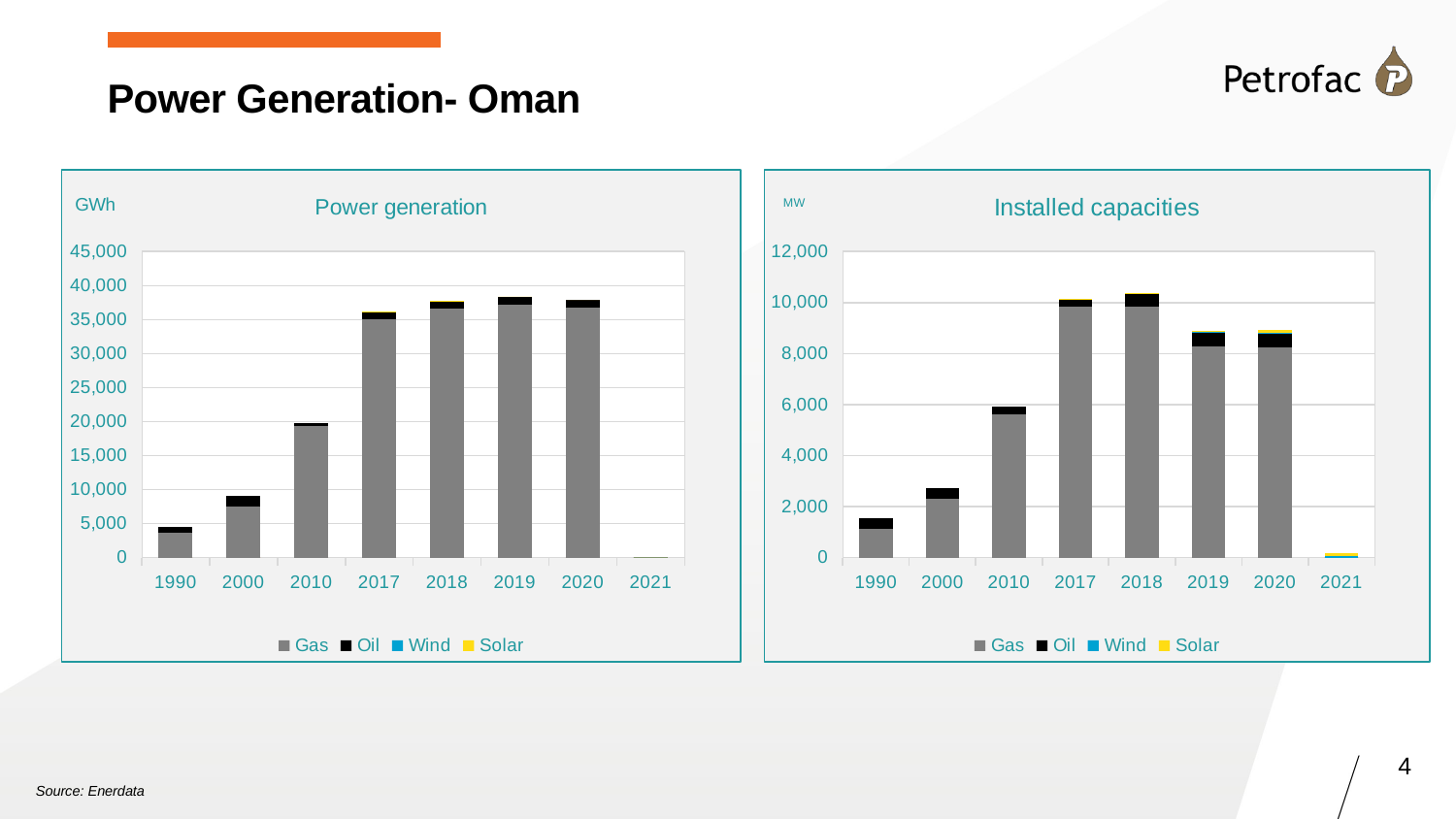
What unit is shown on the y axis of the Installed capacities chart? MW In the Power generation chart, is the total for 1990 greater or less than 10,000? less What kind of chart is the Power generation chart? bar chart In the Installed capacities chart, is the total for 2019 greater or less than 10,000? less In the Installed capacities chart, which year has the lowest total? 2021 In the Power generation chart, is the total for 2010 greater or less than 15,000? greater In the Installed capacities chart, do the totals rise or fall from 1990 to 2017? rise How many years are shown on the x axis of the Installed capacities chart? 8 In the Power generation chart, which year has the lowest total? 2021 In the Power generation chart, which is larger, the total for 2010 or the total for 2017? 2017 How many series does the legend of the Power generation chart list? 4